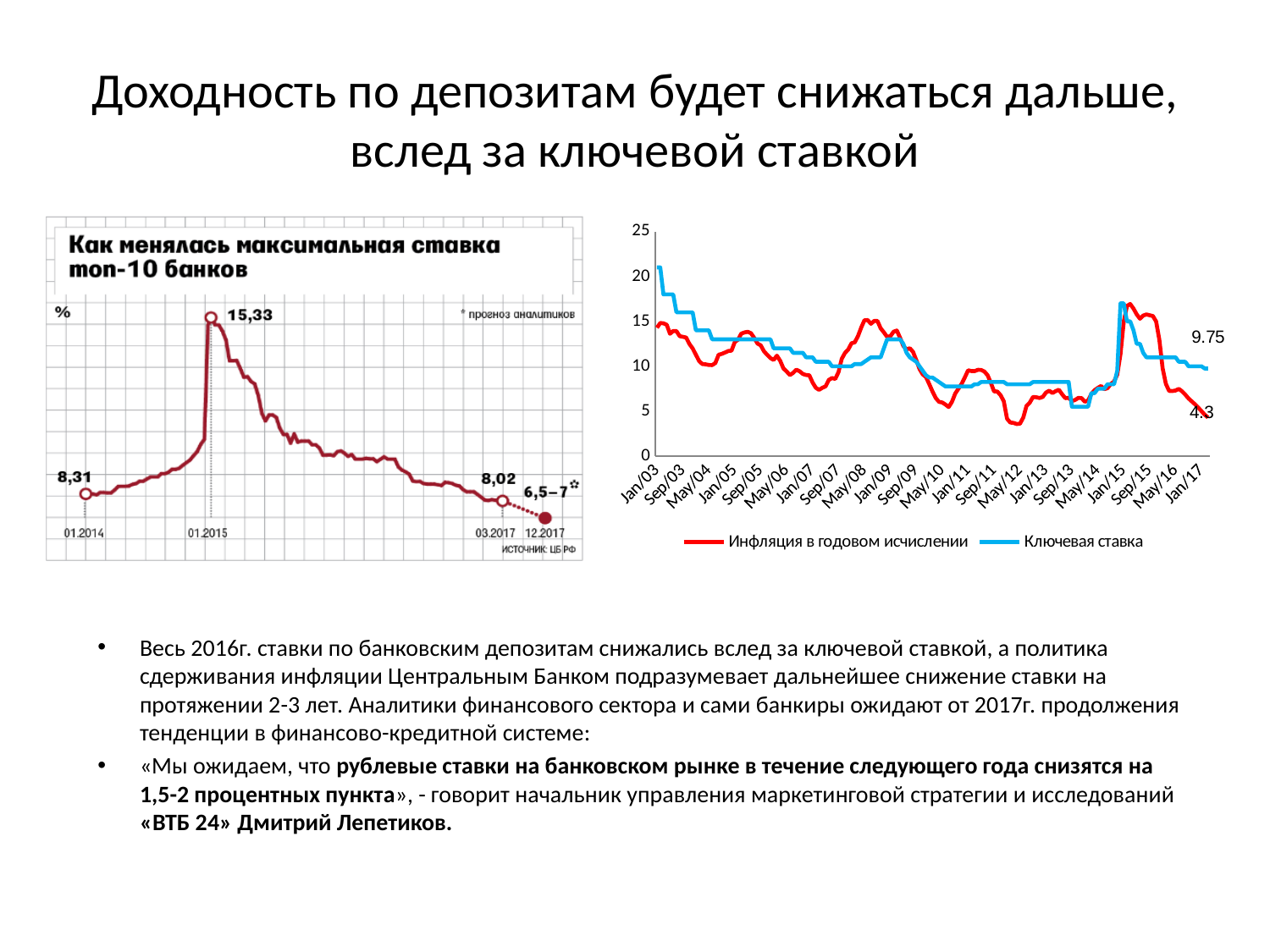
On the right chart, how many series does the legend list? 2 On the right chart, what type of chart is shown? Line chart On the left chart 'Как менялась максимальная ставка топ-10 банков', which is larger: the value in 01.2014 or the value in 03.2017? 01.2014 On the right chart, what is the last labelled value of the 'Ключевая ставка' series? 9.75 On the right chart, which series is drawn in blue? Ключевая ставка On the left chart 'Как менялась максимальная ставка топ-10 банков', at which date does the rate reach its peak? 01.2015 On the left chart 'Как менялась максимальная ставка топ-10 банков', what is the difference between the 01.2015 value and the 03.2017 value? 7,31 On the left chart 'Как менялась максимальная ставка топ-10 банков', what was the maximum rate in 01.2015? 15,33 On the left chart 'Как менялась максимальная ставка топ-10 банков', what is the analysts' forecast for 12.2017? 6,5–7 On the left chart 'Как менялась максимальная ставка топ-10 банков', what was the rate in 03.2017? 8,02 On the right chart, what is the last labelled value of the 'Инфляция в годовом исчислении' series? 4.3 On the left chart 'Как менялась максимальная ставка топ-10 банков', what was the rate in 01.2014? 8,31